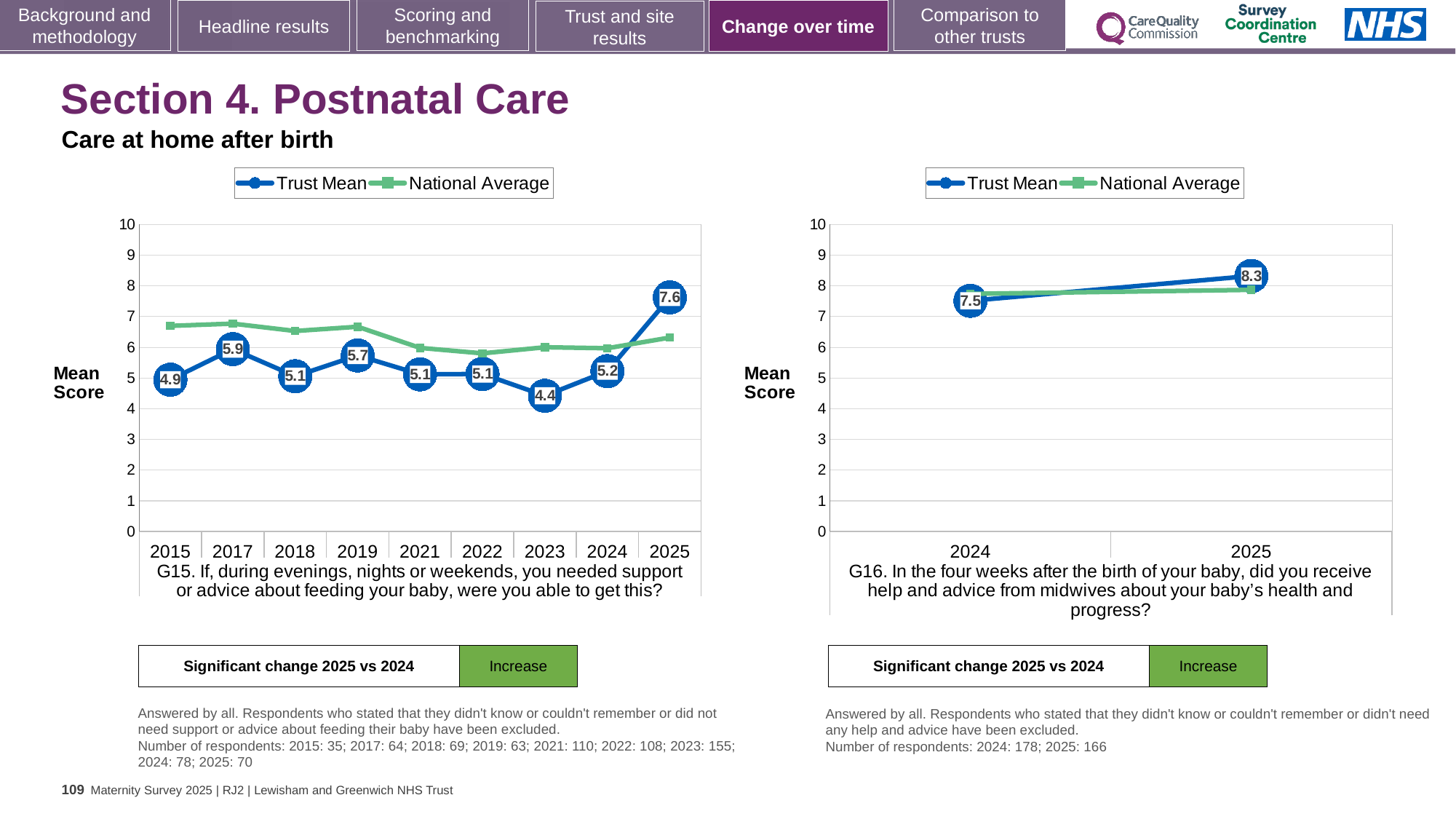
In the G16 chart on the right, does the Trust Mean rise or fall from 2024 to 2025? rise In the G15 chart on the left, which year has the lowest Trust Mean score? 2023 In the G15 chart on the left, is the National Average value for 2015 greater or less than 6? greater In the G16 chart on the right, what is the difference between the Trust Mean scores for 2025 and 2024? 0.8 In the G16 chart on the right, what is the Trust Mean score for 2024? 7.5 In the G15 chart on the left, what is the difference between the Trust Mean scores for 2025 and 2024? 2.4 In the G15 chart on the left, what is the Trust Mean score for 2025? 7.6 How many series does the legend of the G16 chart on the right list? 2 In the G15 chart on the left, what is the Trust Mean score for 2023? 4.4 In the G15 chart on the left, is the Trust Mean score higher in 2017 or in 2019? 2017 In the G15 chart on the left, which year has the highest Trust Mean score? 2025 How many years are plotted on the x axis of the G15 chart on the left? 9